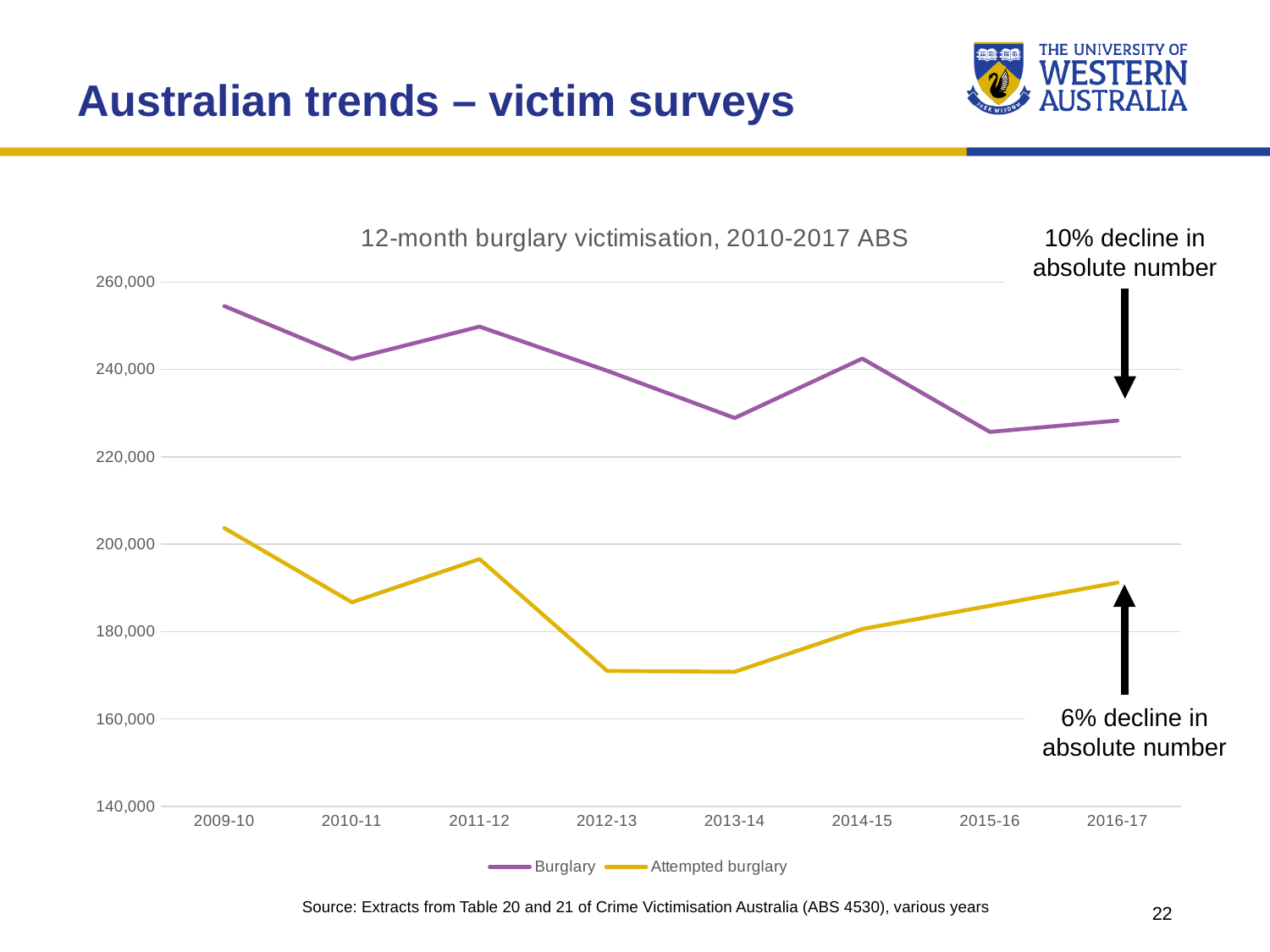
In which period is the Attempted burglary series at its highest? 2009-10 For Attempted burglary, which is larger, the value in 2011-12 or the value in 2012-13? 2011-12 What is the title of the chart? 12-month burglary victimisation, 2010-2017 ABS What kind of chart is shown on the slide? Line chart How many time periods are plotted along the x axis? 8 Is the value for Attempted burglary in 2012-13 greater or less than 180,000? less How many series does the legend list? 2 Is the value for Burglary in 2013-14 greater or less than 240,000? less Does the Attempted burglary series rise or fall from 2013-14 to 2016-17? Rise In which period is the Burglary series at its highest? 2009-10 Which is larger in 2009-10, Burglary or Attempted burglary? Burglary Is the value for Attempted burglary in 2016-17 greater or less than 180,000? greater